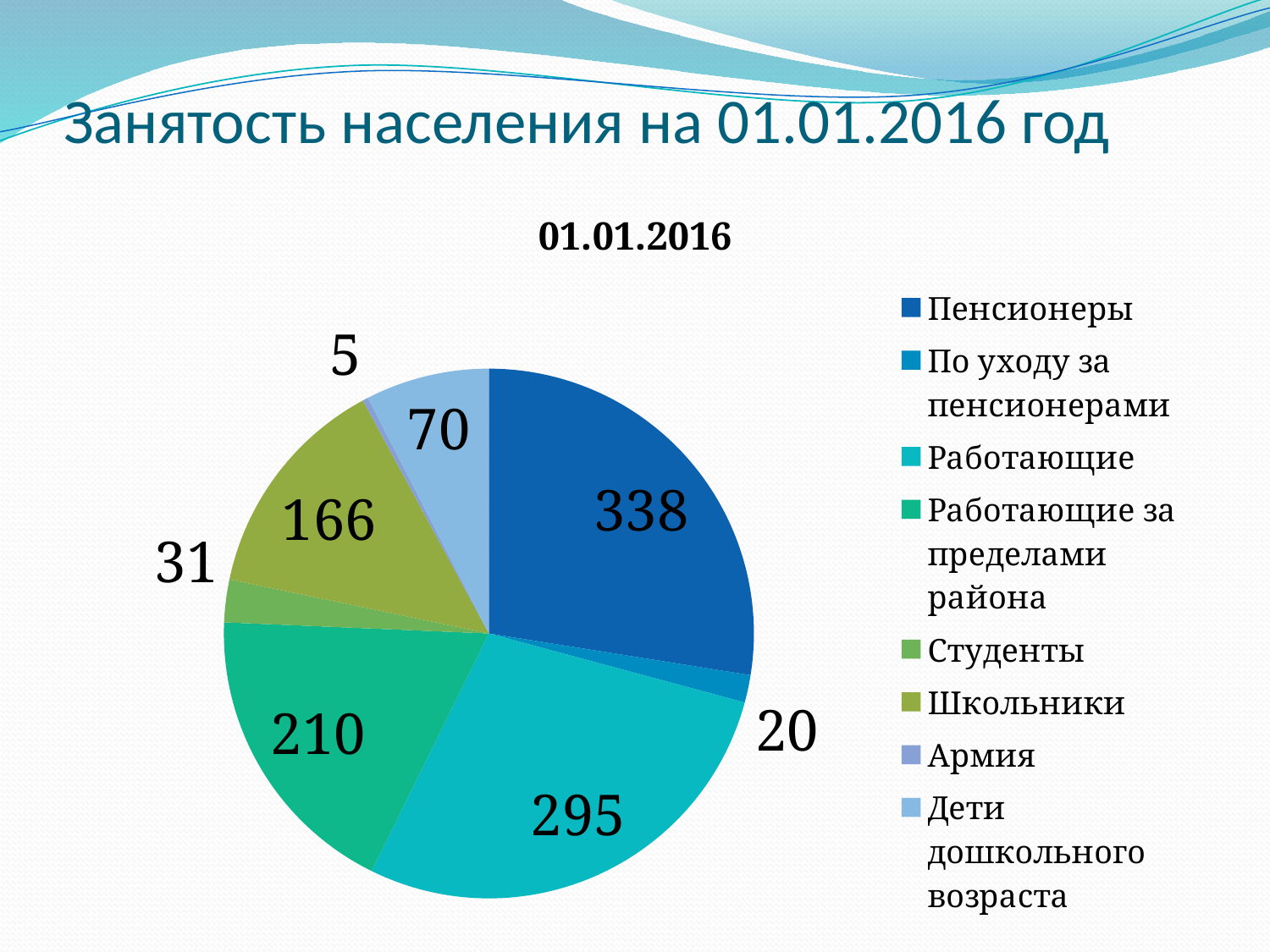
Which is larger: Работающие за пределами района or Школьники? Работающие за пределами района What is the value for Армия in the pie chart? 5 What is the value for Школьники in the pie chart? 166 What is the title shown above the pie chart? 01.01.2016 What is the difference between the values for Пенсионеры and Работающие? 43 What is the value for Работающие in the pie chart? 295 How many categories does the legend list? 8 What is the value for Дети дошкольного возраста in the pie chart? 70 Which category has the smallest slice in the pie chart? Армия Which category has the largest slice in the pie chart? Пенсионеры What is the value for Пенсионеры in the pie chart? 338 What type of chart is shown on the slide? Pie chart